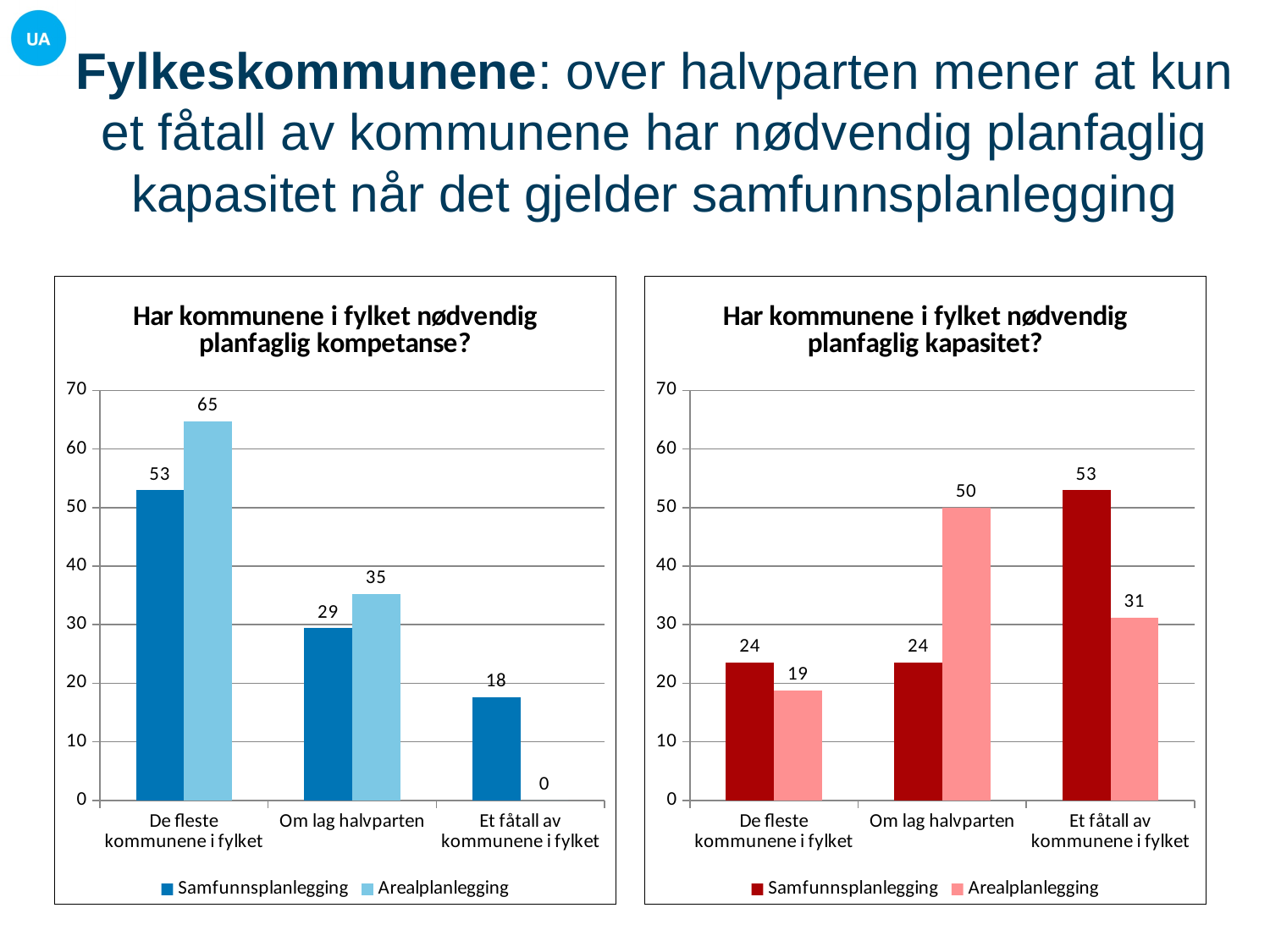
In the right chart (planfaglig kapasitet), which is larger for 'Om lag halvparten': Samfunnsplanlegging or Arealplanlegging? Arealplanlegging In the left chart (planfaglig kompetanse), what is the value for Arealplanlegging for 'De fleste kommunene i fylket'? 65 In the right chart (planfaglig kapasitet), what is the difference between the Samfunnsplanlegging and Arealplanlegging values for 'Et fåtall av kommunene i fylket'? 22 How many categories are shown on the x axis of the left chart (planfaglig kompetanse)? 3 In the left chart (planfaglig kompetanse), what is the value for Samfunnsplanlegging for 'Et fåtall av kommunene i fylket'? 18 In the right chart (planfaglig kapasitet), which category has the lowest Arealplanlegging value? De fleste kommunene i fylket In the left chart (planfaglig kompetanse), which category has the highest Samfunnsplanlegging value? De fleste kommunene i fylket How many series does the legend of the right chart (planfaglig kapasitet) list? 2 In the left chart (planfaglig kompetanse), what is the difference between the Arealplanlegging and Samfunnsplanlegging values for 'De fleste kommunene i fylket'? 12 In the right chart (planfaglig kapasitet), what is the value for Samfunnsplanlegging for 'Et fåtall av kommunene i fylket'? 53 In the right chart (planfaglig kapasitet), what is the value for Arealplanlegging for 'Om lag halvparten'? 50 What kind of chart is the left chart (planfaglig kompetanse)? Bar chart